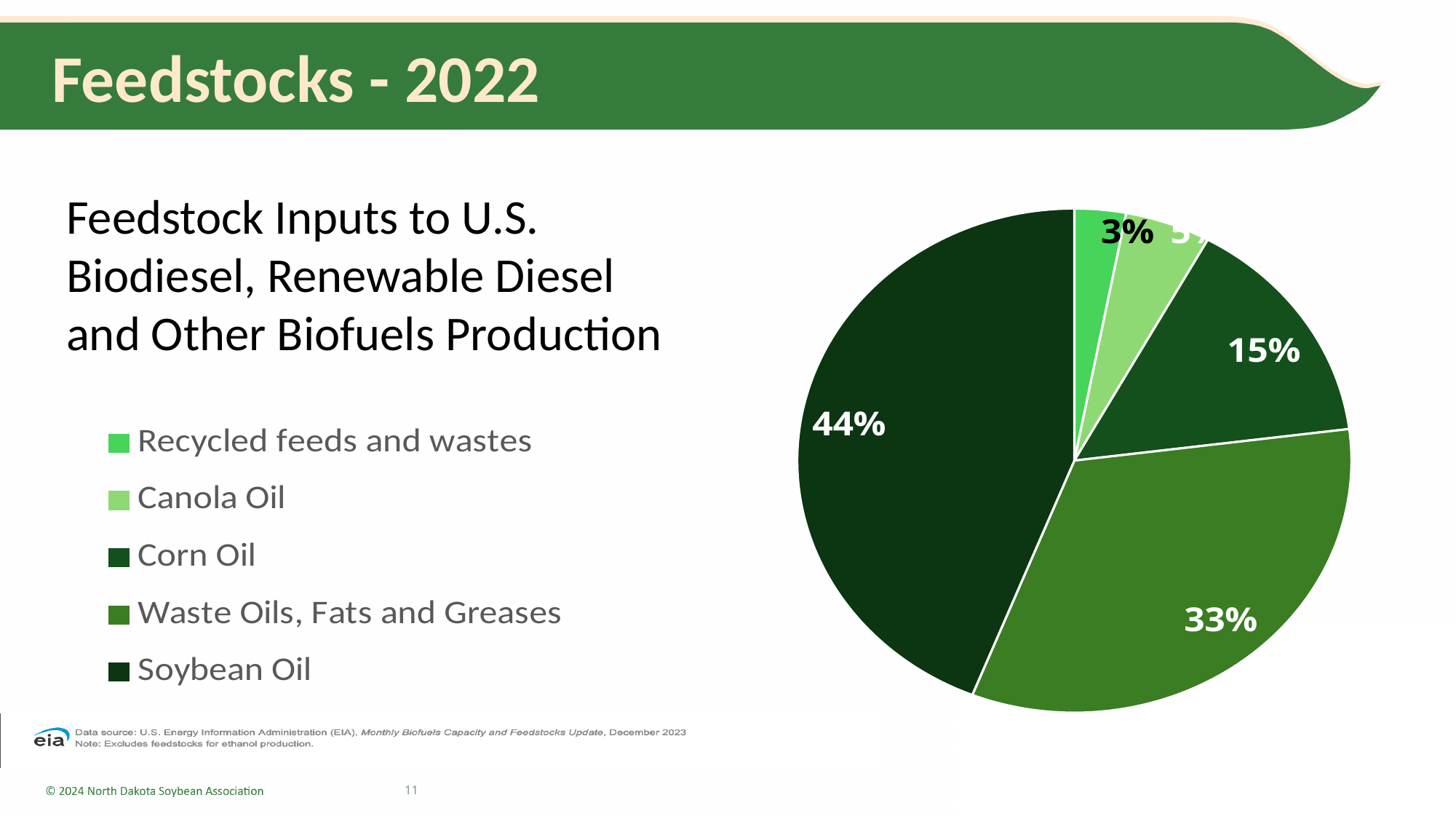
What percentage is shown for Corn Oil? 15% What is the title of the chart on the slide? Feedstock Inputs to U.S. Biodiesel, Renewable Diesel and Other Biofuels Production What percentage is shown for Recycled feeds and wastes? 3% How many feedstock categories does the pie chart show? 5 What share of the pie does Soybean Oil account for? 44% What kind of chart is shown on the slide? Pie chart How many percentage points larger is the Soybean Oil share than the Waste Oils, Fats and Greases share? 11 percentage points How many percentage points larger is the Waste Oils, Fats and Greases share than the Corn Oil share? 18 percentage points Which feedstock has the largest share of the pie? Soybean Oil Which feedstock has the smallest share of the pie? Recycled feeds and wastes What percentage is shown for Waste Oils, Fats and Greases? 33% Which has the larger share: Corn Oil or Waste Oils, Fats and Greases? Waste Oils, Fats and Greases